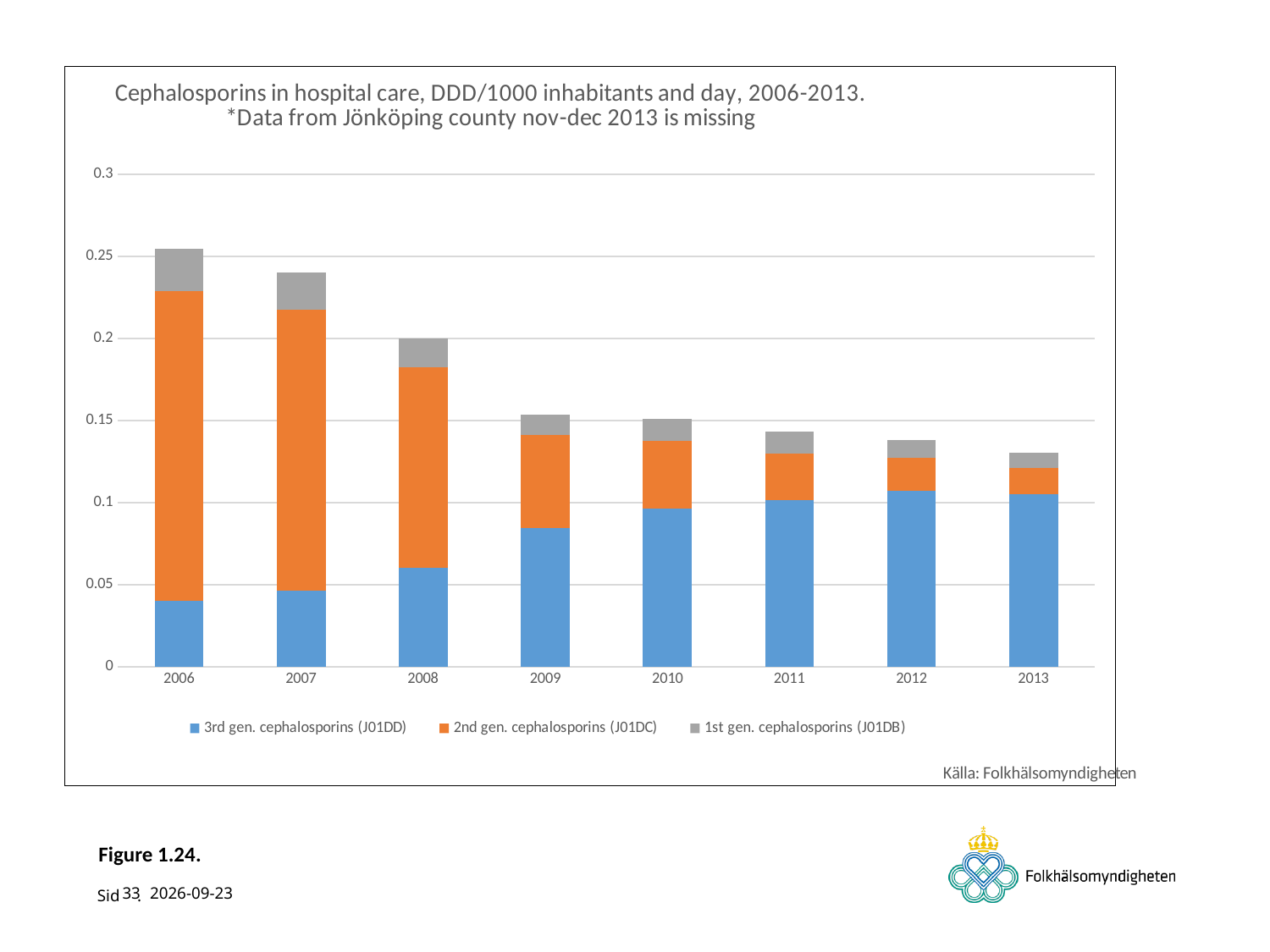
Do the total bar heights rise or fall from 2006 to 2013? Fall Which series is shown in orange in the legend? 2nd gen. cephalosporins (J01DC) How many years are shown on the x axis of the chart? 8 Which year has the highest total cephalosporin use? 2006 What kind of chart is shown on the slide? Stacked bar chart Is the total value for 2013 greater or less than 0.15? less Which year has the lowest total cephalosporin use? 2013 Is the value for 3rd gen. cephalosporins (J01DD) in 2009 greater or less than 0.1? less How many series does the legend list? 3 Is the total value for 2007 greater or less than 0.25? less Which is larger, the 3rd gen. cephalosporins (J01DD) value in 2006 or in 2013? 2013